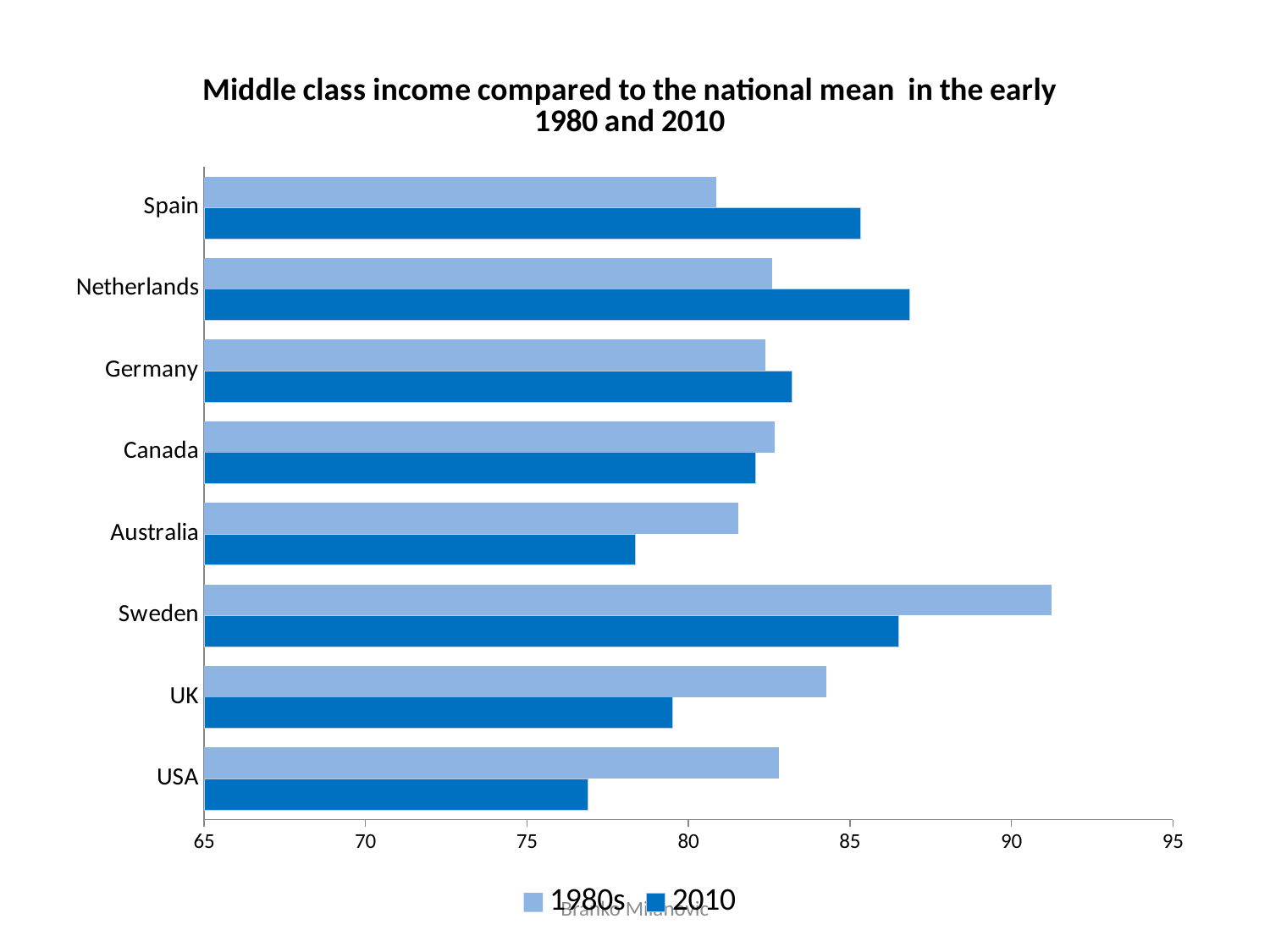
Is the 1980s value for Sweden greater or less than 90? greater What kind of chart is shown on the slide? bar chart Is the 2010 value for Australia greater or less than 80? less For Spain, which series has the larger value, 1980s or 2010? 2010 Which country has the highest value for the 1980s series? Sweden Which country has the lowest value for the 2010 series? USA Is the 2010 value for Netherlands greater or less than 85? greater How many countries are shown on the chart? 8 How many series does the legend list? 2 What are the two series named in the legend? 1980s and 2010 For the USA, which series has the larger value, 1980s or 2010? 1980s